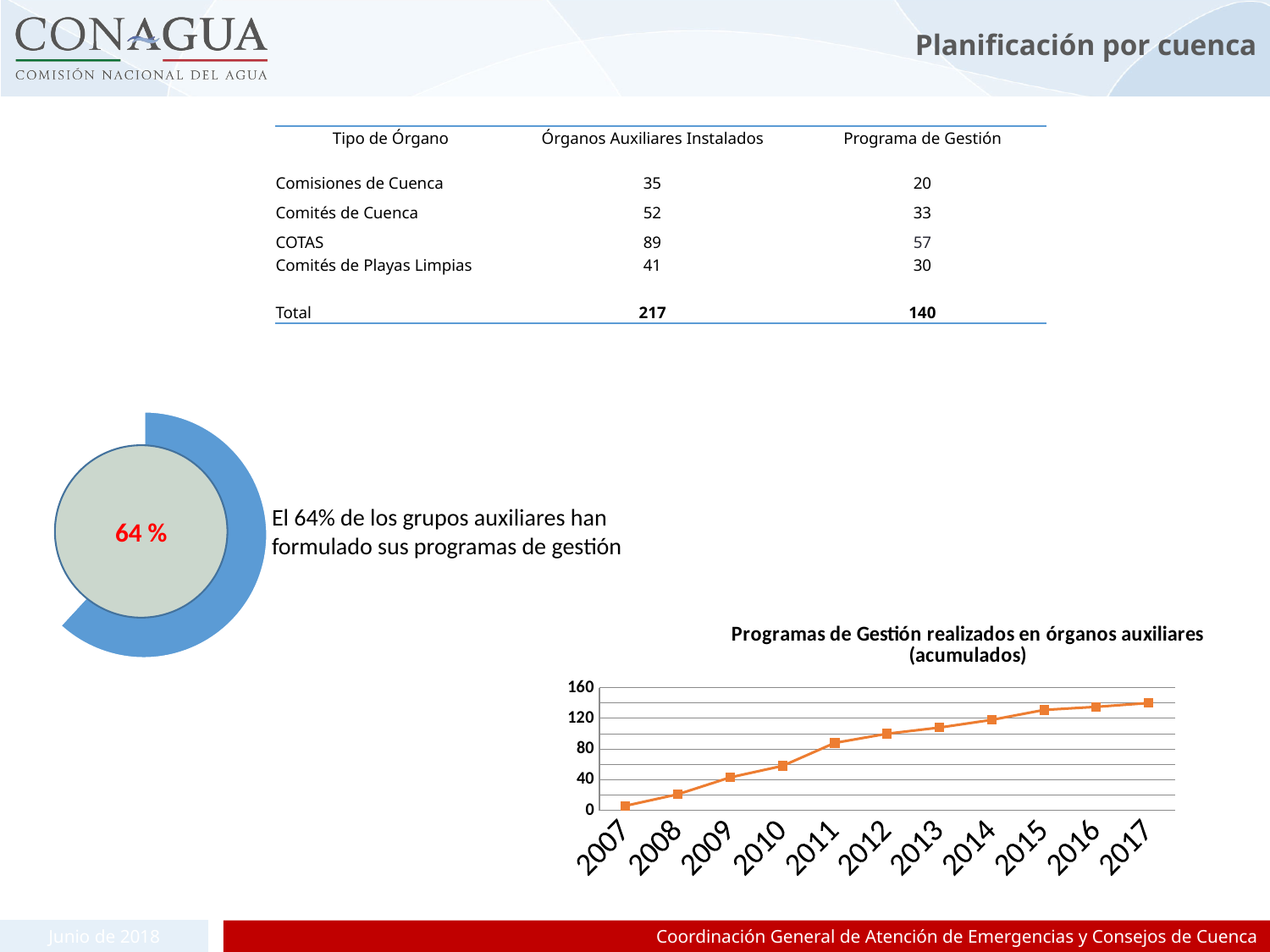
What percentage is shown in the circular chart on the left of the slide? 64 % In the 'Programas de Gestión realizados en órganos auxiliares (acumulados)' chart, which year has the lowest value? 2007 What is the highest tick value shown on the y axis of the 'Programas de Gestión realizados en órganos auxiliares (acumulados)' chart? 160 In the 'Programas de Gestión realizados en órganos auxiliares (acumulados)' chart, which year has the highest value? 2017 In the 'Programas de Gestión realizados en órganos auxiliares (acumulados)' chart, is the value for 2008 greater or less than 40? less In the 'Programas de Gestión realizados en órganos auxiliares (acumulados)' chart, which year has the larger value, 2010 or 2012? 2012 In the 'Programas de Gestión realizados en órganos auxiliares (acumulados)' chart, is the value for 2013 greater or less than 120? less How many years are plotted on the x axis of the 'Programas de Gestión realizados en órganos auxiliares (acumulados)' chart? 11 What kind of chart is 'Programas de Gestión realizados en órganos auxiliares (acumulados)'? line chart In the 'Programas de Gestión realizados en órganos auxiliares (acumulados)' chart, is the value for 2010 greater or less than 40? greater In the 'Programas de Gestión realizados en órganos auxiliares (acumulados)' chart, do the values rise or fall from 2007 to 2017? rise